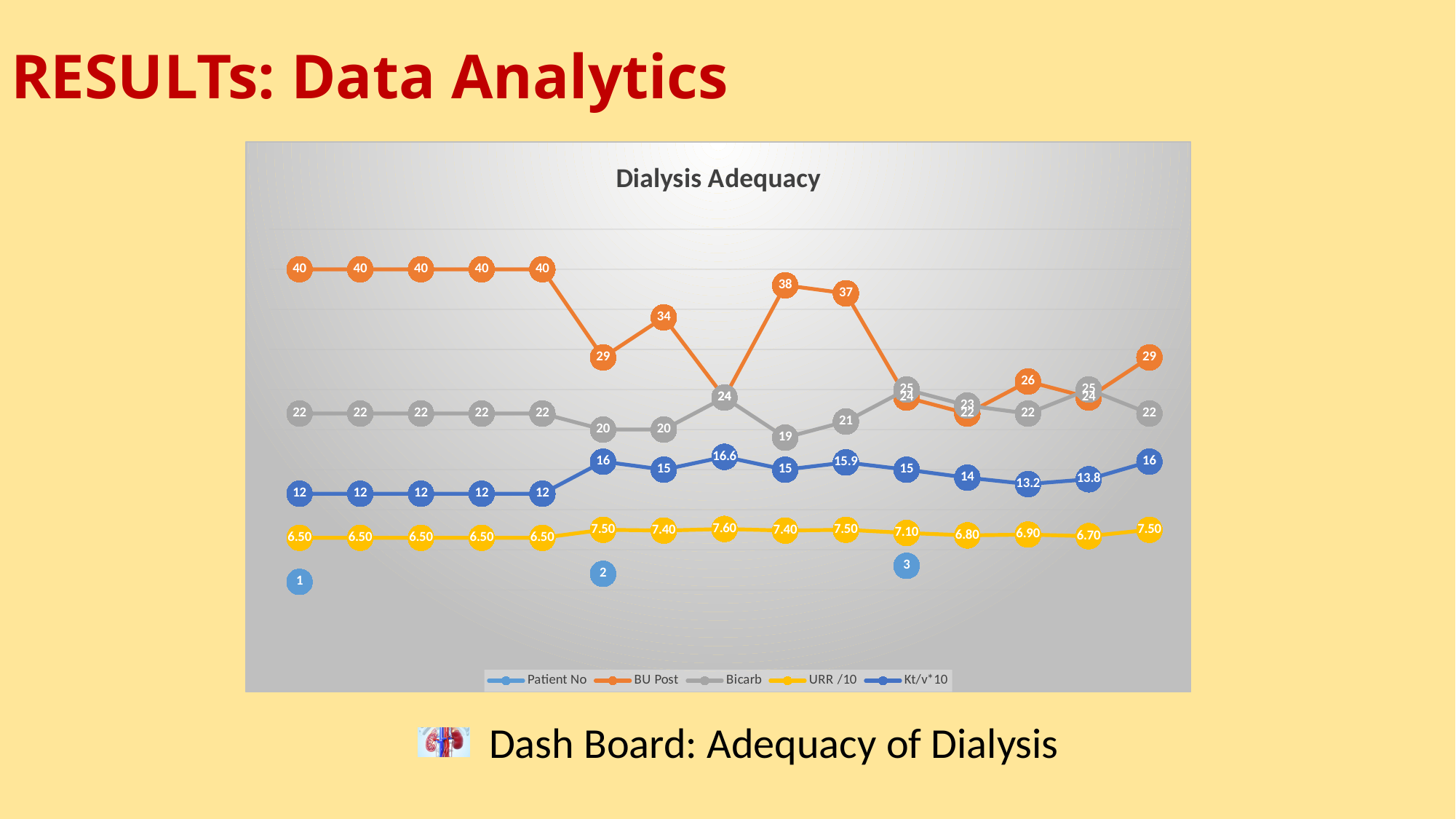
How many series does the legend list? 5 What is the title of the chart? Dialysis Adequacy What is the value of the last (rightmost) point of the URR /10 series? 7.50 How many data points are plotted for the Kt/v*10 series? 15 What type of chart is shown on the slide? line chart What is the highest value plotted for the Kt/v*10 series? 16.6 What is the value of the last (rightmost) point of the BU Post series? 29 What is the lowest value plotted for the Bicarb series? 19 At the last (rightmost) point, what is the difference between the BU Post value and the Bicarb value? 7 What is the highest value plotted for the BU Post series? 40 At the first (leftmost) point, which series has the larger value, BU Post or Bicarb? BU Post What is the highest value plotted for the URR /10 series? 7.60